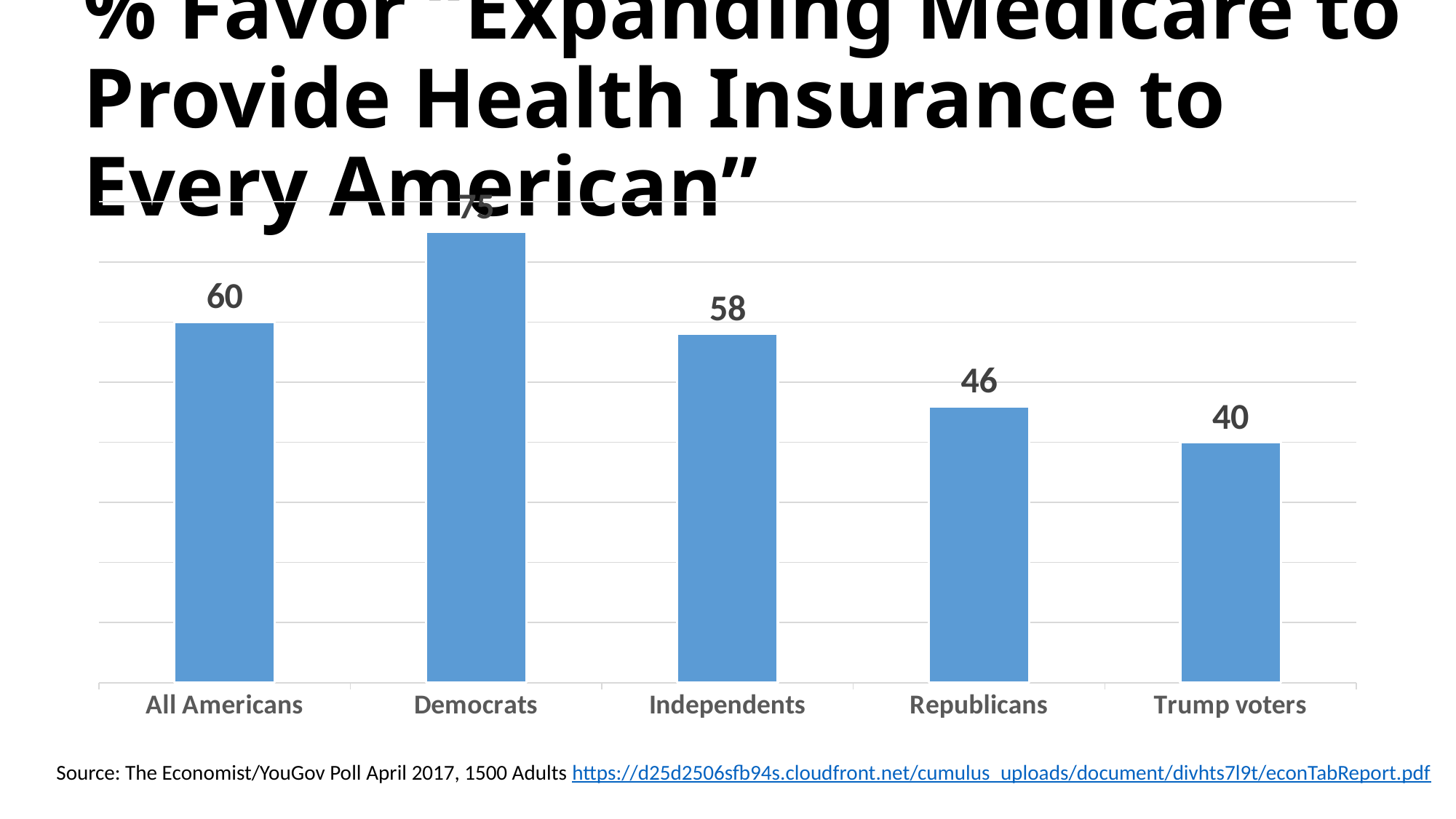
What is the difference between the values for Republicans and Trump voters? 6 What is the value for Trump voters? 40 What is the value for All Americans? 60 What is the value for Independents? 58 What is the source of the poll data cited on the slide? The Economist/YouGov Poll April 2017, 1500 Adults Which category has the lowest value? Trump voters How many categories are shown on the x axis? 5 Which category has the highest value? Democrats Which is larger, the value for Independents or the value for Republicans? Independents What is the value for Republicans? 46 What kind of chart is shown on the slide? Bar chart What is the difference between the values for All Americans and Trump voters? 20